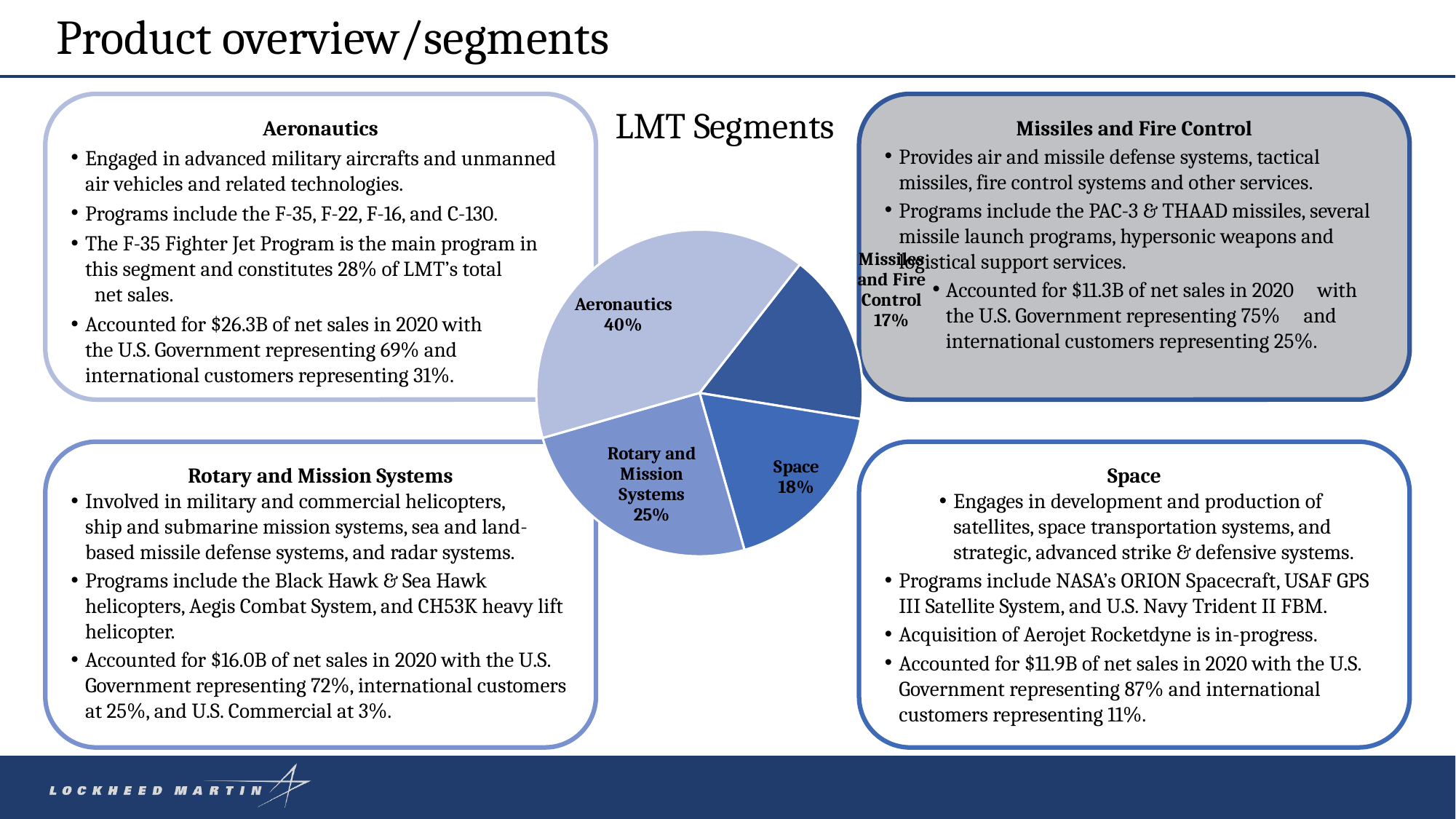
What is the difference in percentage points between Aeronautics and Rotary and Mission Systems? 15 What share of the pie does Space represent? 18% What share of the pie does Aeronautics represent? 40% Which segment has the smallest share of the pie? Missiles and Fire Control What share of the pie does Rotary and Mission Systems represent? 25% What is the combined share of Space and Missiles and Fire Control? 35% Which is larger, the share for Space or the share for Rotary and Mission Systems? Rotary and Mission Systems What share of the pie does Missiles and Fire Control represent? 17% What kind of chart is shown on the slide? pie chart How many segments does the pie chart show? 4 Which segment has the largest share of the pie? Aeronautics What is the title of the chart? LMT Segments